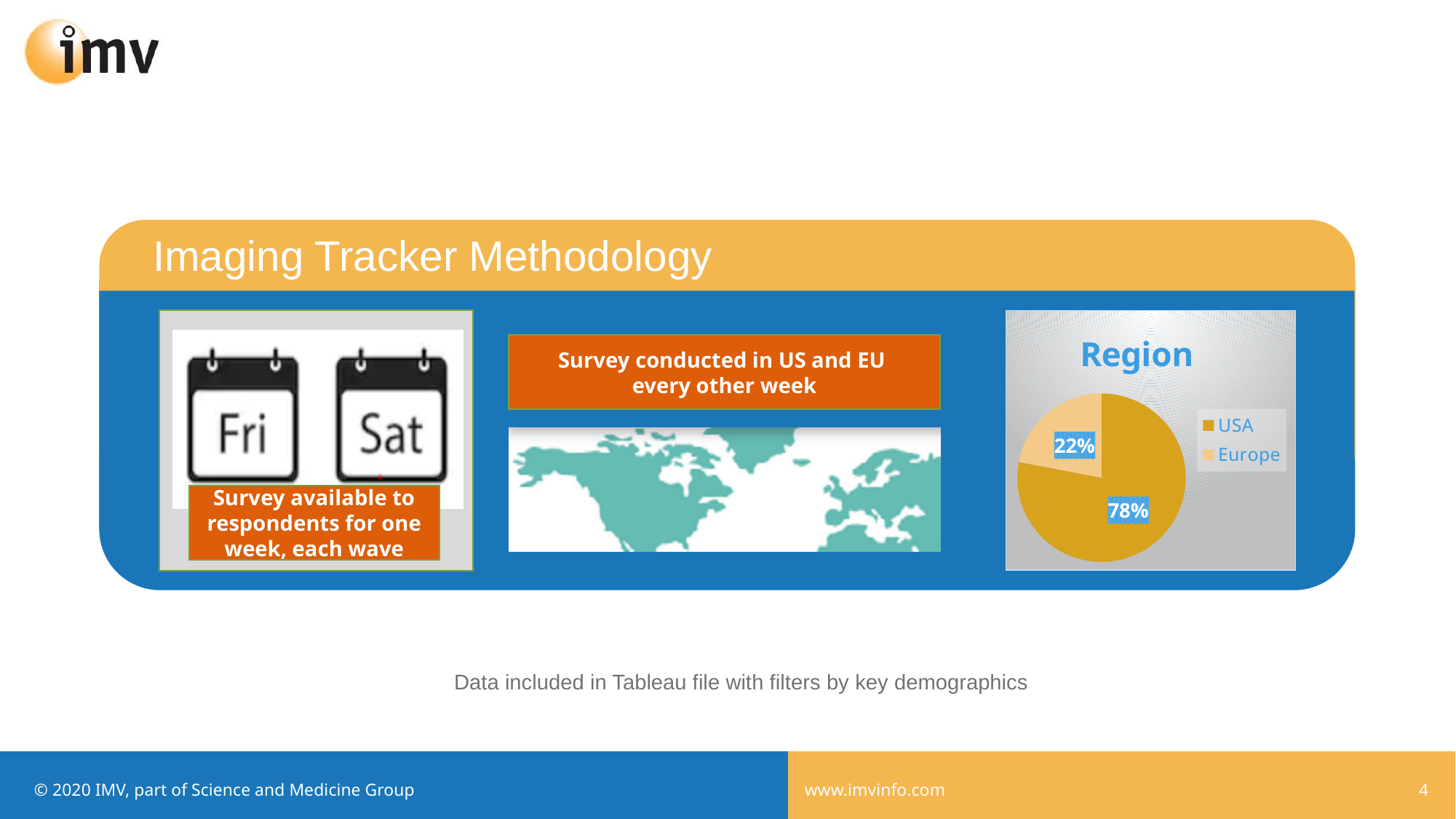
Which region has the smallest slice in the Region pie chart? Europe How many entries does the legend of the Region pie chart list? 2 What is the title of the pie chart? Region What type of chart is the Region chart? pie chart What share of the Region pie chart is Europe? 22% What share of the Region pie chart is USA? 78% What is the difference in percentage points between the USA and Europe slices in the Region pie chart? 56 Which region has the largest slice in the Region pie chart? USA Which legend entry in the Region pie chart is shown in the lighter shade? Europe How many slices does the Region pie chart have? 2 Which is larger in the Region pie chart, USA or Europe? USA